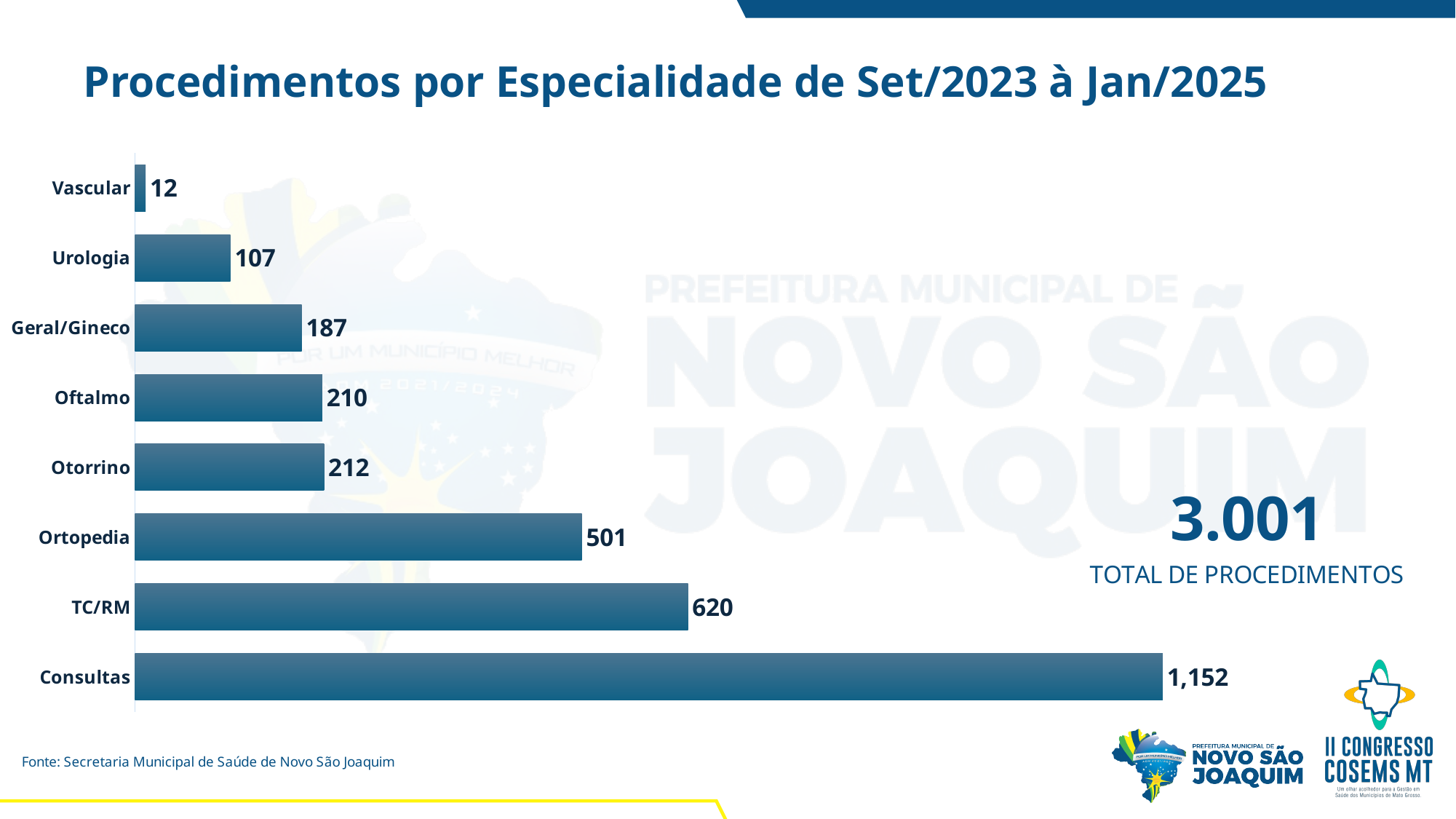
How many specialties are shown in the chart? 8 What is the difference between the values for TC/RM and Ortopedia? 119 What is the value for Consultas? 1,152 What is the value for Ortopedia? 501 Which specialty has the highest value? Consultas What kind of chart is shown on the slide? Bar chart What is the difference between the values for Consultas and TC/RM? 532 Which is larger, the value for Urologia or the value for Geral/Gineco? Geral/Gineco Which specialty has the lowest value? Vascular What is the value for Vascular? 12 What is the title of the chart? Procedimentos por Especialidade de Set/2023 à Jan/2025 What is the value for Geral/Gineco? 187